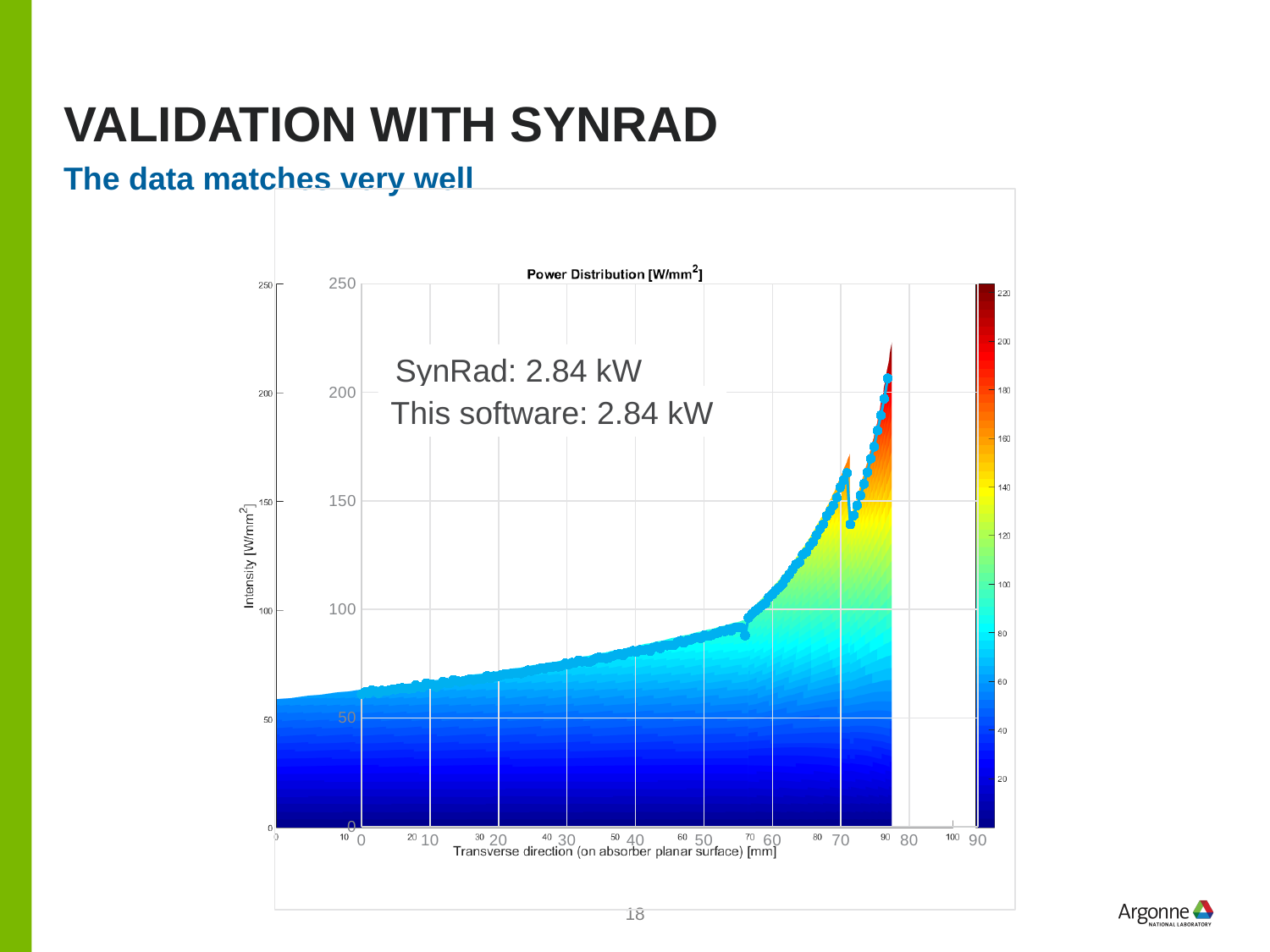
Does the plotted intensity generally rise or fall as the transverse direction increases along the x axis? rise Is the intensity at a transverse position of 70 mm greater or less than 100 W/mm2? greater Is the SynRad total power larger than, smaller than, or equal to the total power from 'This software'? equal What is the title of the chart? Power Distribution [W/mm2] Is the peak intensity on the chart greater or less than 150 W/mm2? greater What total power does the chart annotation give for SynRad? 2.84 kW Is the intensity at a transverse position of 10 mm greater or less than 100 W/mm2? less What is the highest tick value shown on the y axis of the chart? 250 What is the highest value labelled on the colour bar of the chart? 220 What total power does the chart annotation give for 'This software'? 2.84 kW What is the label of the y axis of the chart? Intensity [W/mm2]